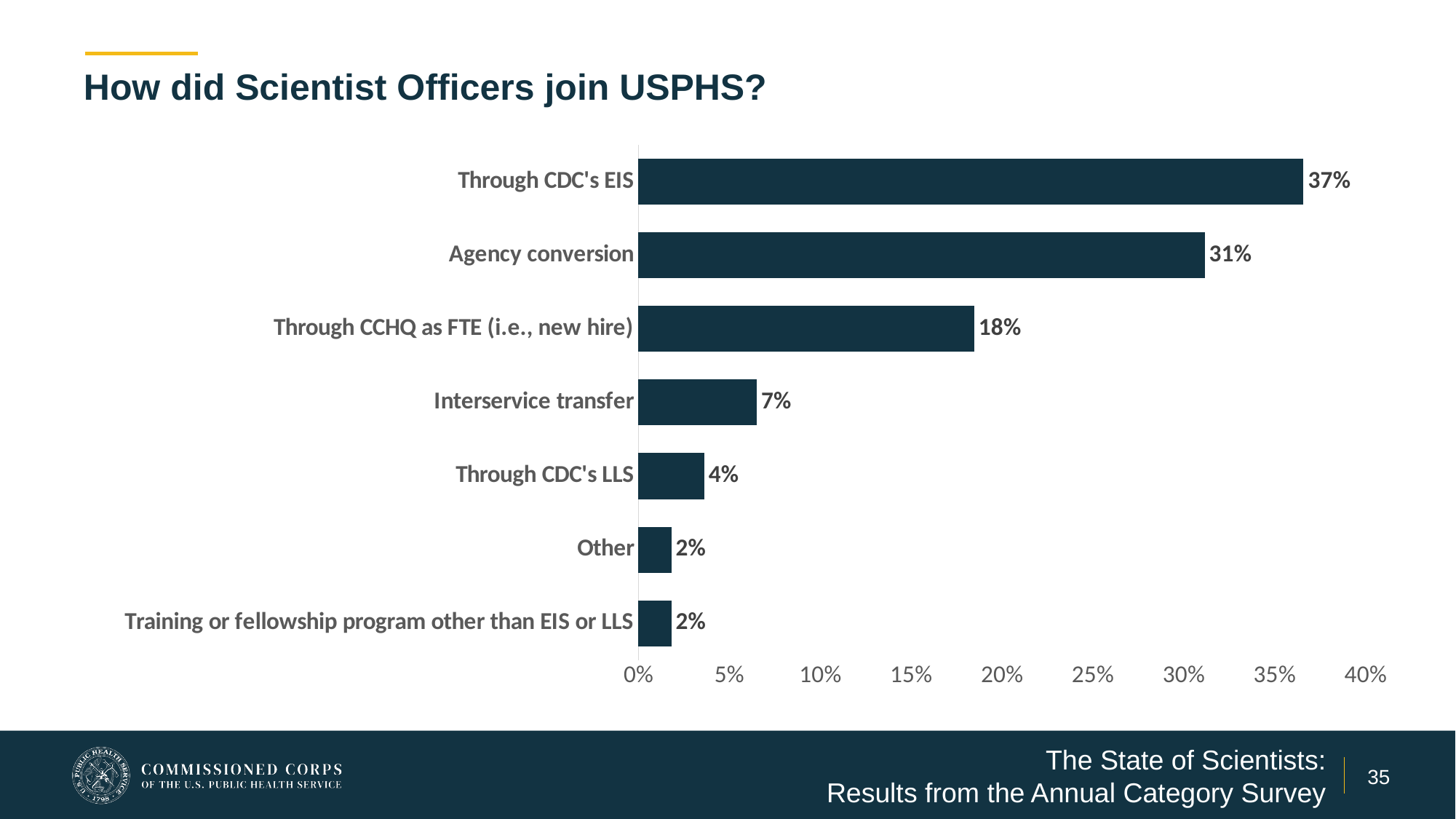
What is the difference between the values for Through CCHQ as FTE (i.e., new hire) and Through CDC's LLS? 14% What percentage joined through CCHQ as FTE (i.e., new hire)? 18% Which category has the highest value? Through CDC's EIS Which is larger, the value for Through CDC's LLS or the value for Interservice transfer? Interservice transfer How many categories are shown in the chart? 7 What kind of chart is shown on the slide? Bar chart What is the value shown for Agency conversion? 31% What is the difference between the values for Through CDC's EIS and Agency conversion? 6% What percentage of Scientist Officers joined USPHS through CDC's EIS? 37% Is the value for Agency conversion greater or less than 30%? greater What is the title of the slide? How did Scientist Officers join USPHS? What is the value for Interservice transfer? 7%